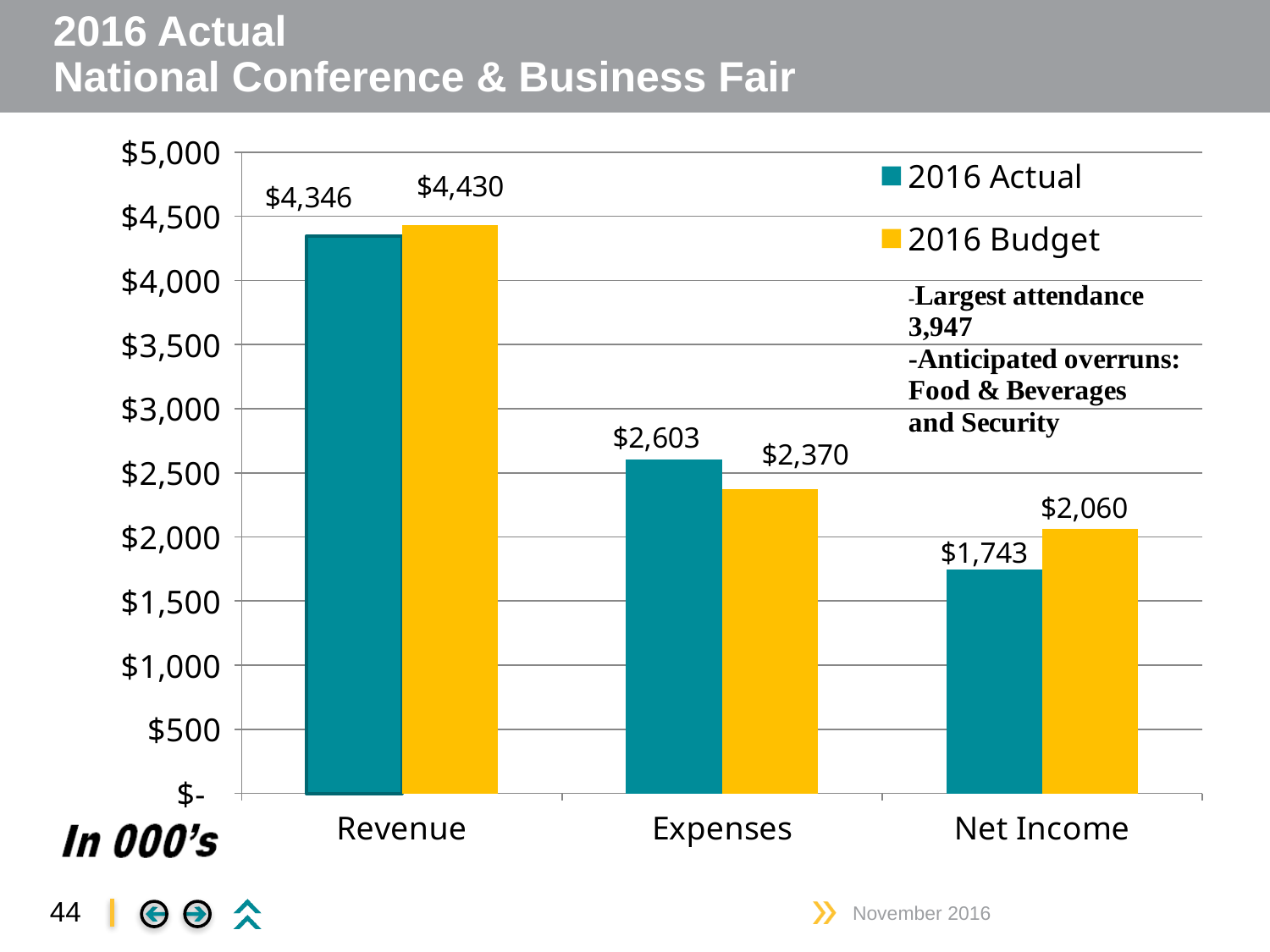
What is the 2016 Budget value for Expenses? $2,370 How many categories are shown on the x axis? 3 What is the 2016 Budget value for Net Income? $2,060 What kind of chart is shown on the slide? bar chart Which is larger for Expenses: 2016 Actual or 2016 Budget? 2016 Actual Is the 2016 Actual value for Net Income greater or less than $2,000? less Which category has the lowest 2016 Budget value? Net Income What is the 2016 Actual value for Net Income? $1,743 What is the 2016 Actual value for Revenue? $4,346 How many series does the legend list? 2 What is the difference between the 2016 Budget and 2016 Actual values for Revenue? $84 Which category has the highest 2016 Actual value? Revenue